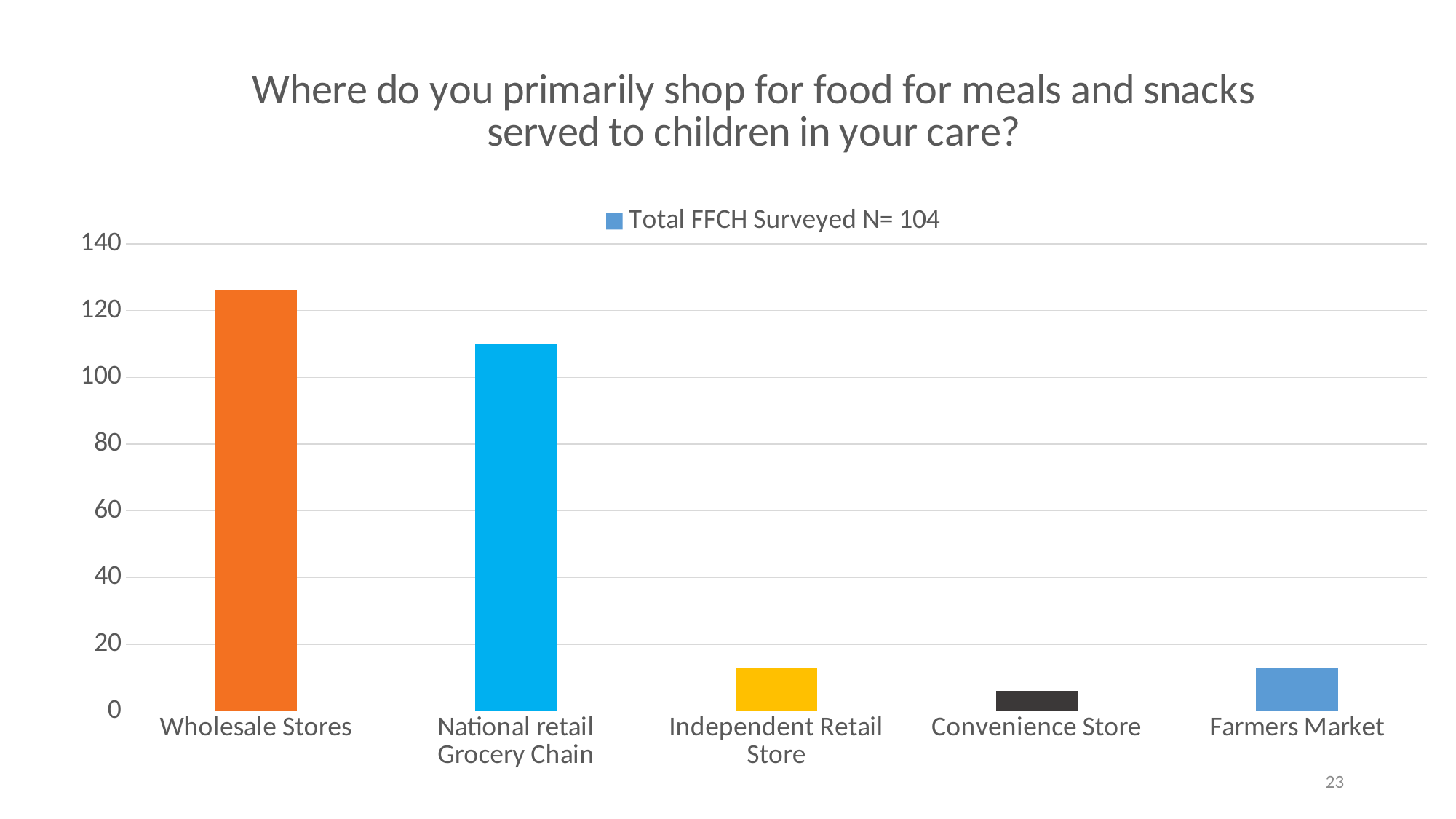
How many categories are shown on the x axis of the chart? 5 Which is larger, the value for Independent Retail Store or the value for Convenience Store? Independent Retail Store Which is larger, the value for Wholesale Stores or the value for National retail Grocery Chain? Wholesale Stores What type of chart is shown on the slide? bar chart Is the value for Wholesale Stores greater or less than 120? greater Which category has the highest value? Wholesale Stores Is the value for Farmers Market greater or less than 20? less How many series does the legend list? 1 What is the title of the chart? Where do you primarily shop for food for meals and snacks served to children in your care? What is the legend entry for the series in the chart? Total FFCH Surveyed N= 104 Is the value for National retail Grocery Chain greater or less than 100? greater Which category has the lowest value? Convenience Store